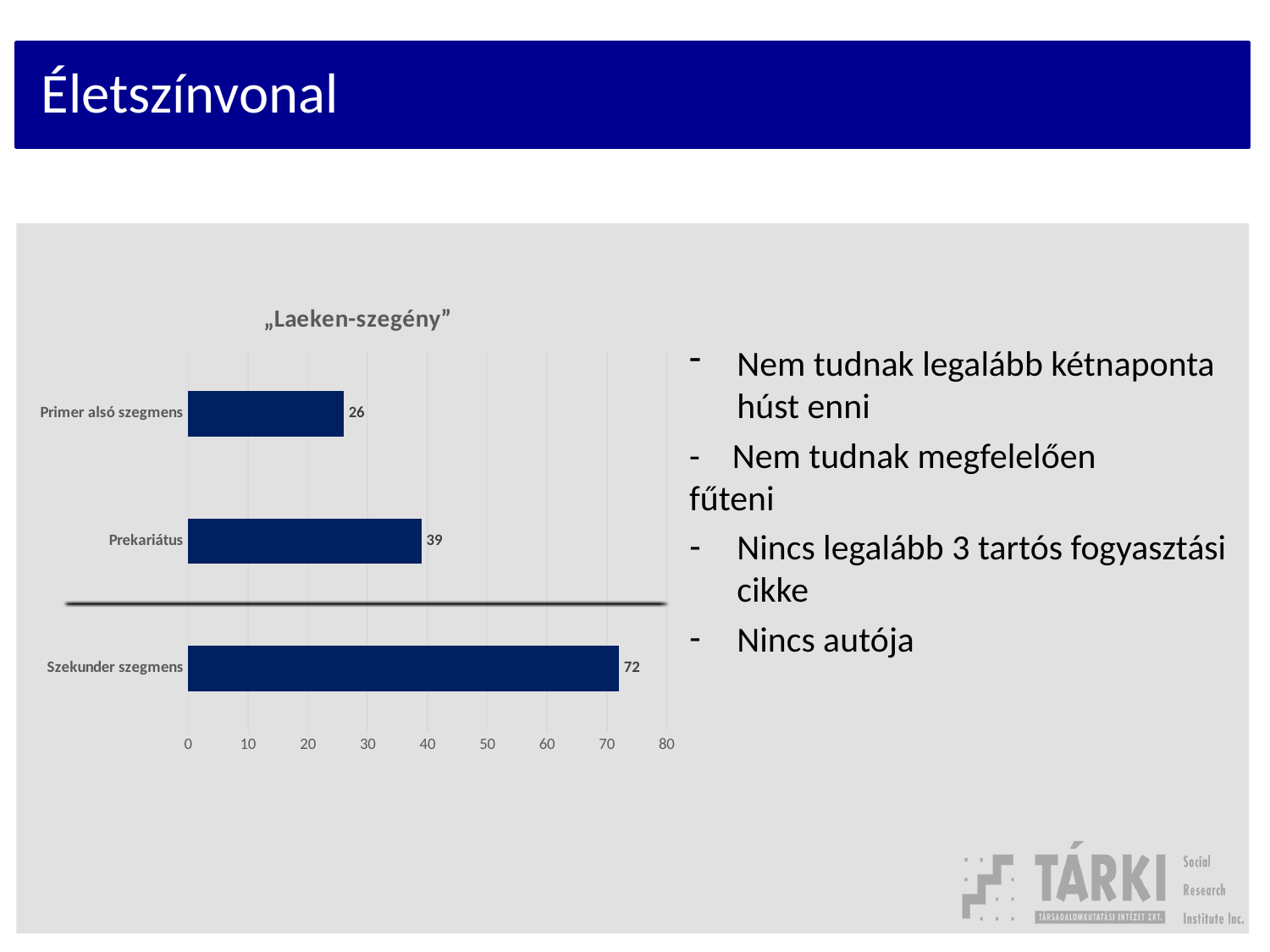
Is the value for Szekunder szegmens greater or less than 70? greater What is the value for Prekariátus in the „Laeken-szegény” chart? 39 What is the value for Szekunder szegmens in the „Laeken-szegény” chart? 72 Which category has the highest value in the „Laeken-szegény” chart? Szekunder szegmens Which category has the lowest value in the „Laeken-szegény” chart? Primer alsó szegmens Which is larger: the value for Prekariátus or the value for Primer alsó szegmens? Prekariátus What kind of chart is shown on the slide? bar chart How many categories are shown in the „Laeken-szegény” chart? 3 What is the difference between the values for Prekariátus and Primer alsó szegmens? 13 What is the title of the chart on the slide? „Laeken-szegény” What is the difference between the values for Szekunder szegmens and Prekariátus? 33 What is the value for Primer alsó szegmens in the „Laeken-szegény” chart? 26